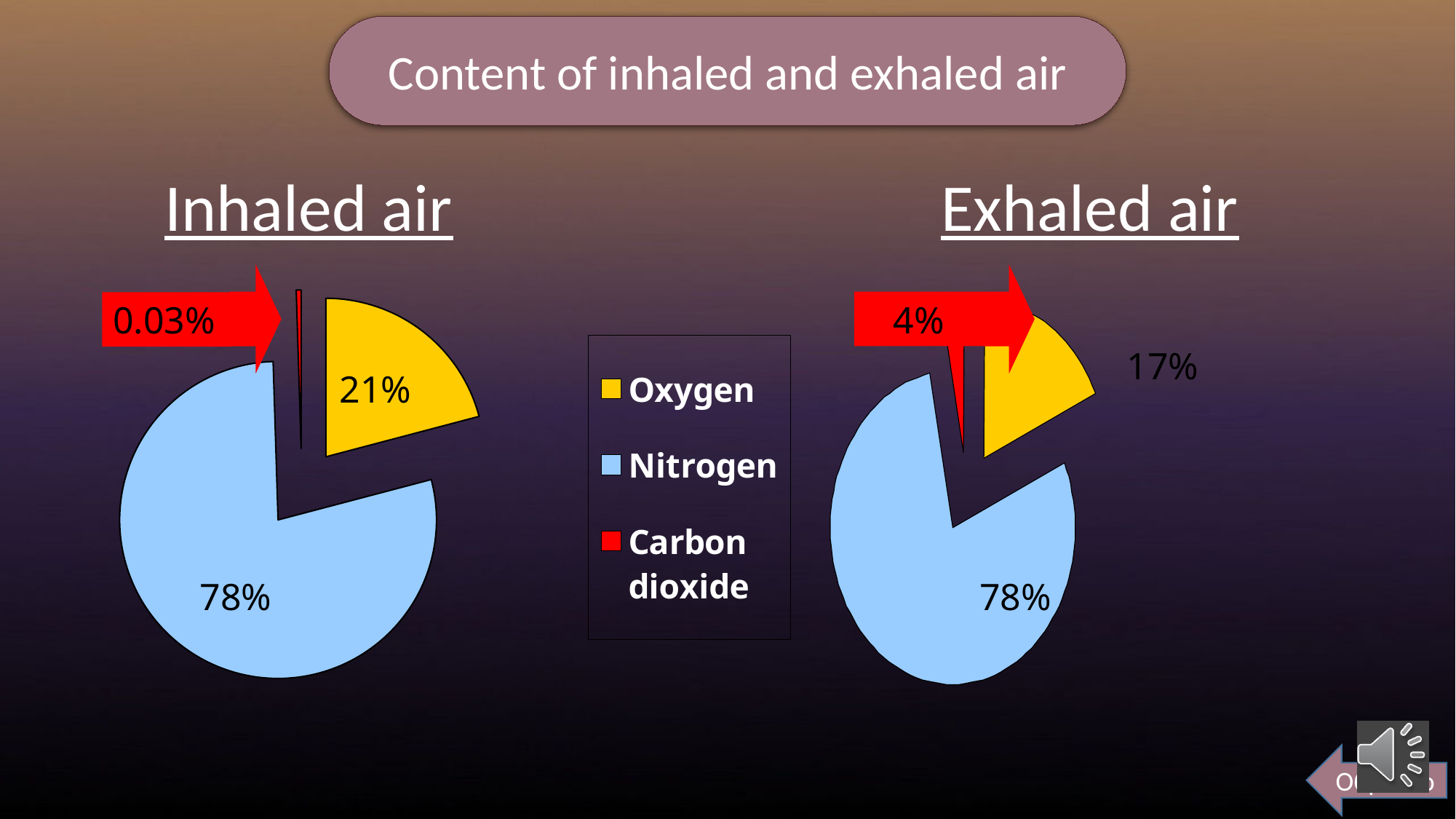
In the Inhaled air chart, what percentage is Oxygen? 21% In the Exhaled air chart, what percentage is Carbon dioxide? 4% Which is larger: the Carbon dioxide share in the Exhaled air chart or in the Inhaled air chart? Exhaled air What colour represents Nitrogen in the charts? Light blue In the Inhaled air chart, what percentage is Nitrogen? 78% In the Inhaled air chart, which component has the smallest share? Carbon dioxide In the Inhaled air chart, what percentage is Carbon dioxide? 0.03% In the Exhaled air chart, what percentage is Oxygen? 17% What type of chart is used for the Inhaled air data? Pie chart In the Exhaled air chart, which component has the largest share? Nitrogen How many components does the legend list? 3 What is the difference between the Oxygen share in the Inhaled air chart and the Oxygen share in the Exhaled air chart? 4%